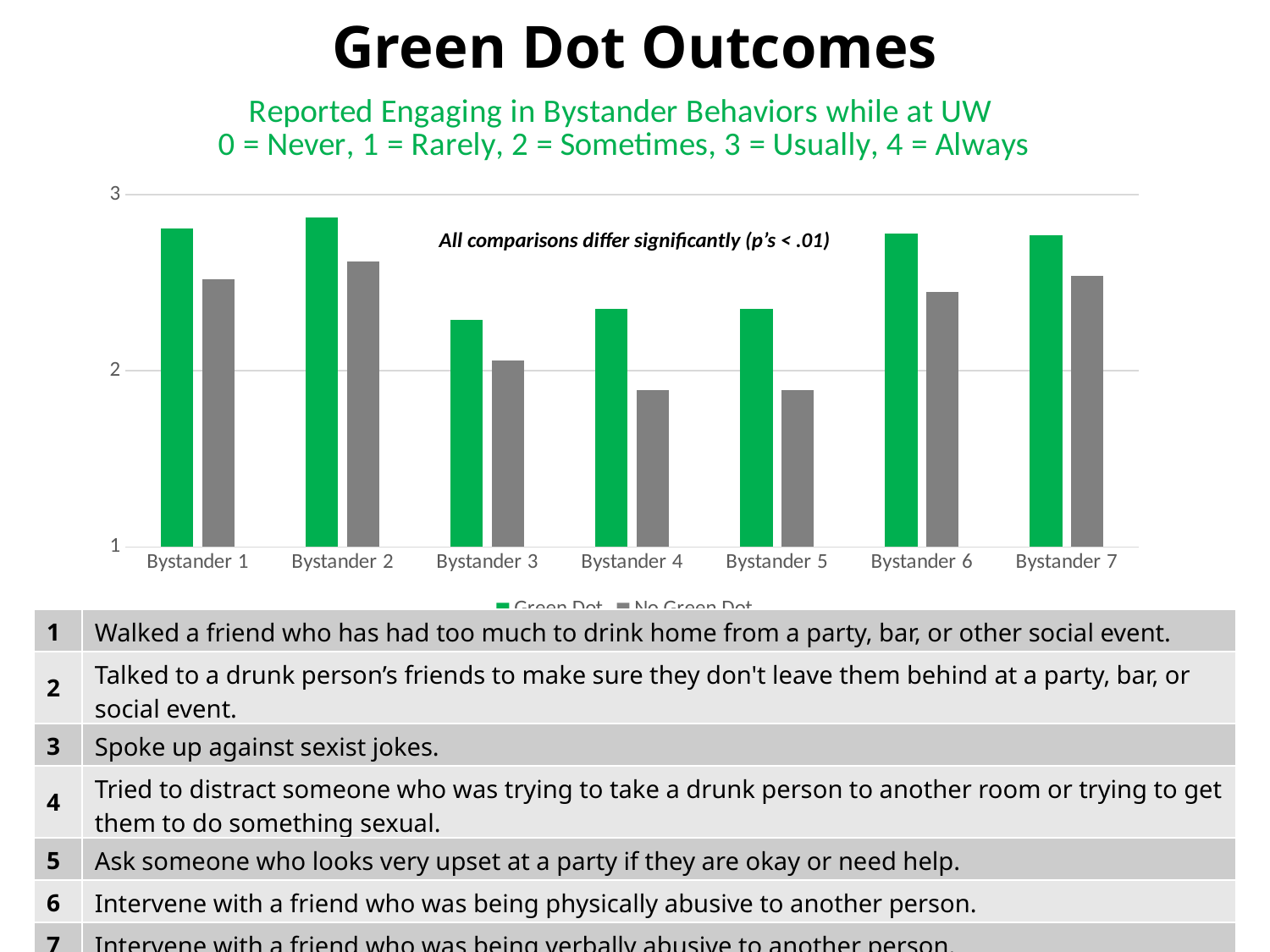
Is the Green Dot value for Bystander 3 greater or less than 2? greater How many series does the legend list? 2 Which colour represents the No Green Dot series? Gray Is the No Green Dot value for Bystander 4 greater or less than 2? less Which bystander category has the highest Green Dot value? Bystander 2 Is the No Green Dot value for Bystander 5 greater or less than 2? less Which series has the higher value for Bystander 4, Green Dot or No Green Dot? Green Dot What kind of chart is shown on the slide? Bar chart What is the title of the chart? Reported Engaging in Bystander Behaviors while at UW 0 = Never, 1 = Rarely, 2 = Sometimes, 3 = Usually, 4 = Always How many bystander behavior categories are shown on the x axis? 7 Which series has the higher value for Bystander 6, Green Dot or No Green Dot? Green Dot